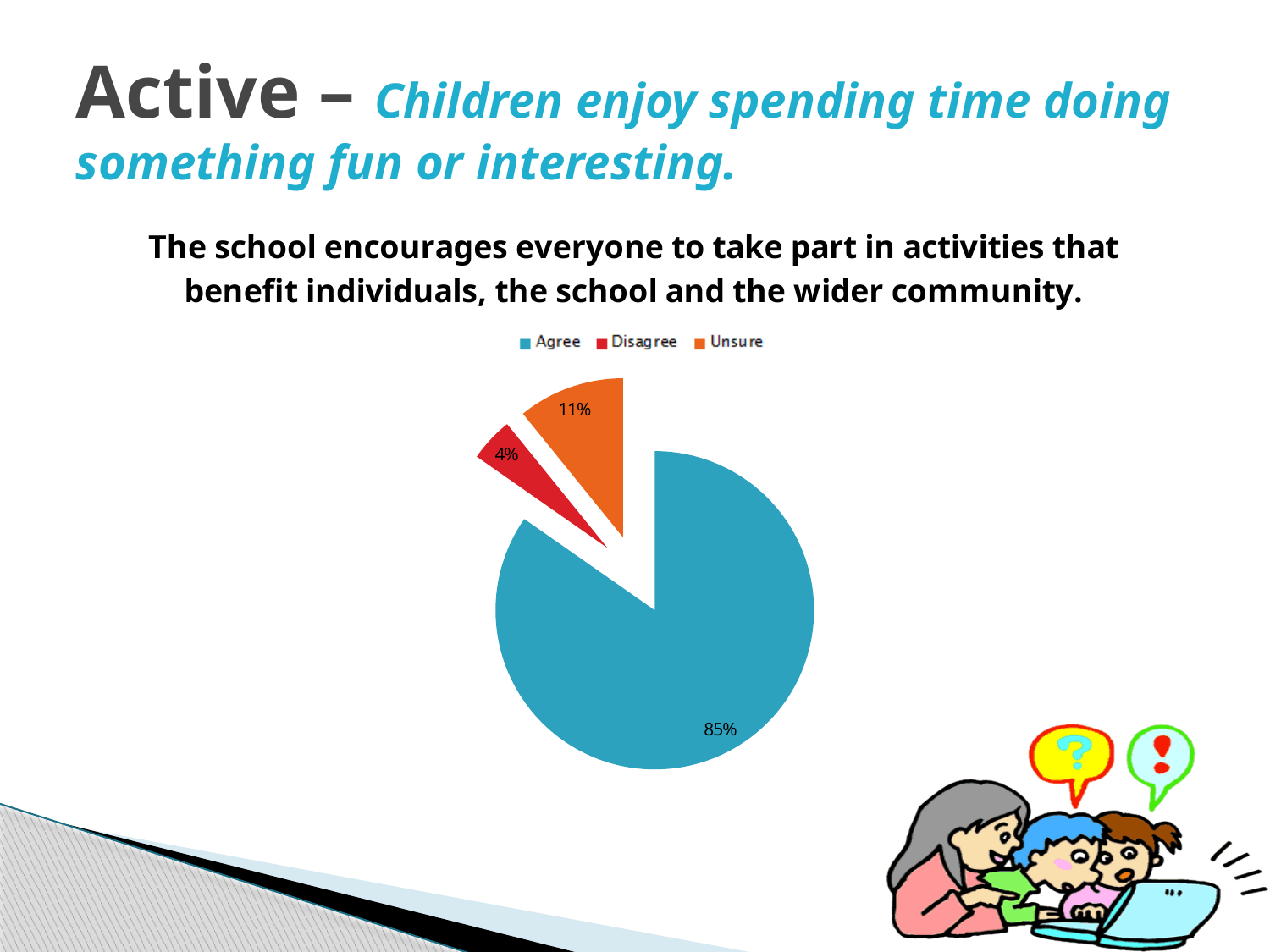
What percentage of respondents chose Agree? 85% How many entries does the legend list? 3 Which response has the smallest share of the pie? Disagree Which response has the largest share of the pie? Agree What kind of chart is shown on the slide? Pie chart What is the difference in percentage points between Unsure and Disagree? 7 What percentage of respondents chose Unsure? 11% How many slices does the pie chart have? 3 What is the difference in percentage points between Agree and Unsure? 74 Which is larger, the share for Unsure or the share for Disagree? Unsure What colour is the Agree slice in the pie chart? Blue What percentage of respondents chose Disagree? 4%